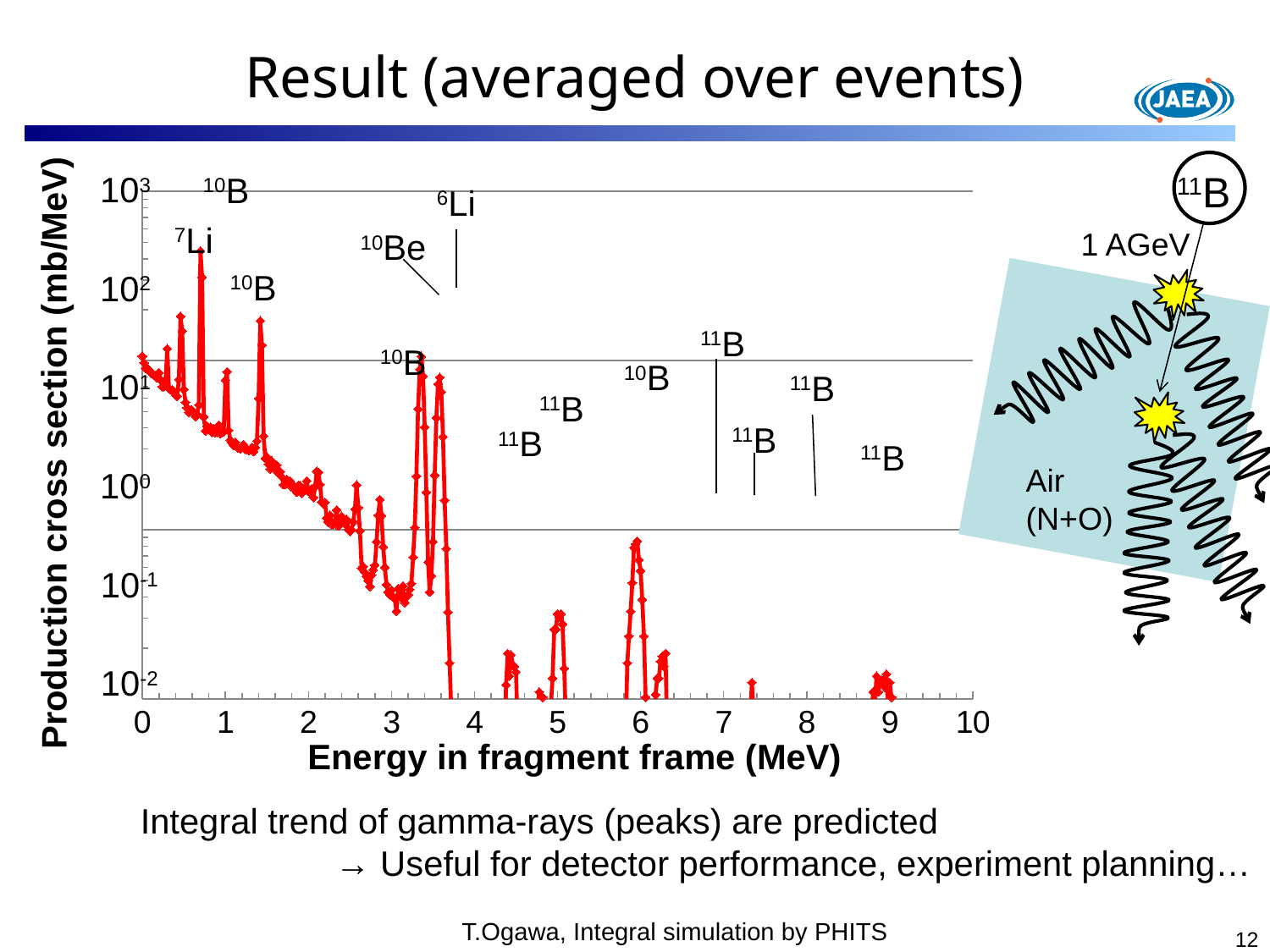
Which labelled isotope corresponds to the highest peak in the spectrum? 7Li Is the value at the 7Li peak (near 0.7 MeV) greater or less than 10^2 mb/MeV? greater Is the value at the peak near 6 MeV greater or less than 10^0 mb/MeV? less Overall, do the plotted values rise or fall as energy increases along the x axis? fall Is the value at the peak near 5 MeV greater or less than 10^-1 mb/MeV? less What is the title of the x axis of the chart? Energy in fragment frame (MeV) What kind of chart is shown on the slide? line chart Which peak is higher: the peak near 6 MeV or the peak near 5 MeV? peak near 6 MeV What is the maximum value shown on the x axis? 10 What is the title of the y axis of the chart? Production cross section (mb/MeV) Which peak is higher: the 7Li peak near 0.7 MeV or the 10B peak near 1.4 MeV? 7Li peak near 0.7 MeV